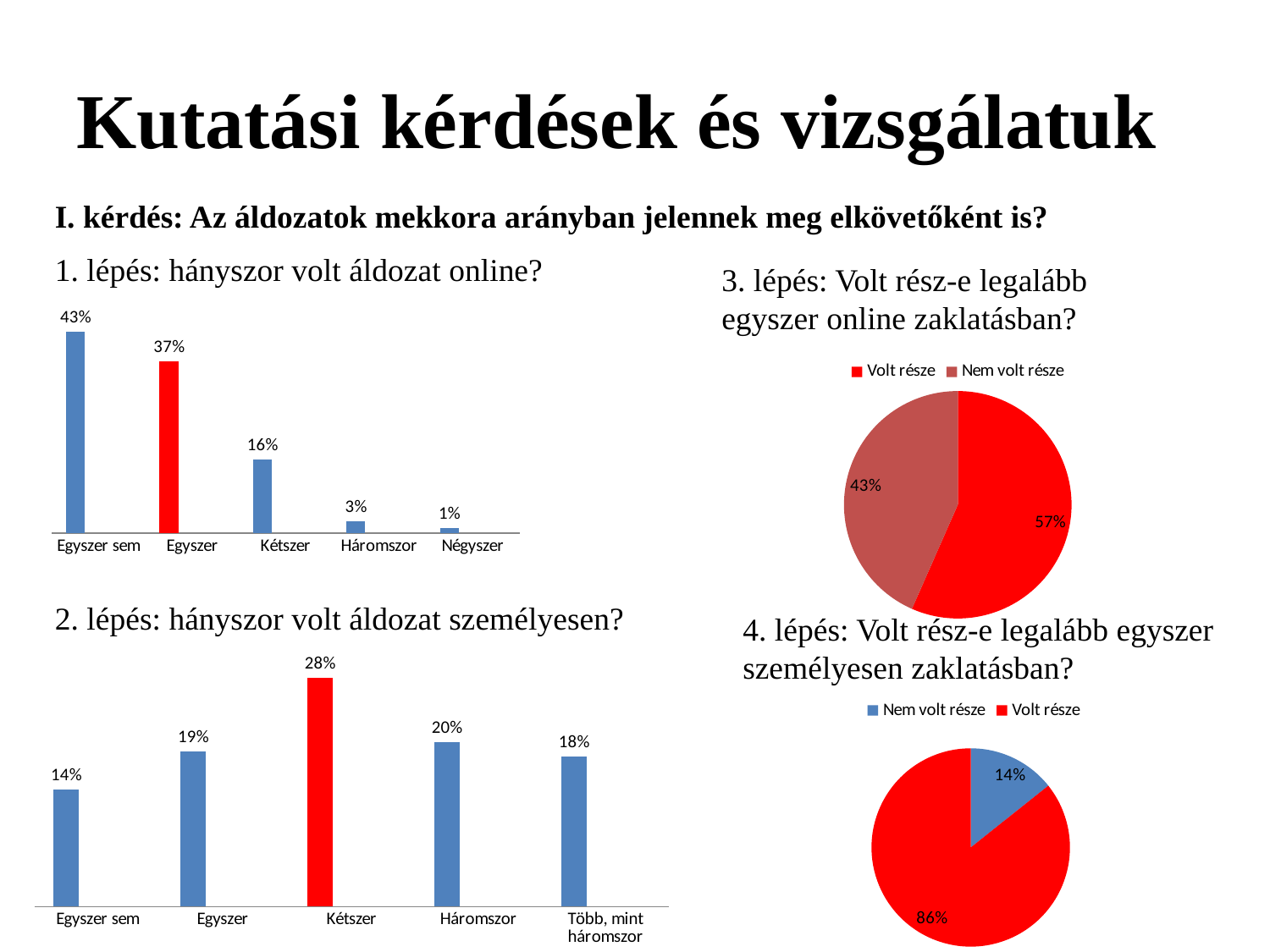
In the top-left bar chart (1. lépés: hányszor volt áldozat online?), which category has the lowest value? Négyszer In the bottom-right pie chart (4. lépés: Volt rész-e legalább egyszer személyesen zaklatásban?), what share is Nem volt része? 14% How many entries does the legend of the top-right pie chart (3. lépés) list? 2 In the bottom-right pie chart (4. lépés: Volt rész-e legalább egyszer személyesen zaklatásban?), which slice is larger: Volt része or Nem volt része? Volt része In the bottom-left bar chart (2. lépés: hányszor volt áldozat személyesen?), what is the value for Több, mint háromszor? 18% In the bottom-left bar chart (2. lépés: hányszor volt áldozat személyesen?), which category has the highest value? Kétszer In the bottom-left bar chart (2. lépés: hányszor volt áldozat személyesen?), which is larger: Egyszer or Háromszor? Háromszor In the top-left bar chart (1. lépés: hányszor volt áldozat online?), what is the value for Egyszer sem? 43% How many categories are shown in the top-left bar chart (1. lépés: hányszor volt áldozat online?)? 5 What type of chart is used for 2. lépés: hányszor volt áldozat személyesen? Bar chart In the top-right pie chart (3. lépés: Volt rész-e legalább egyszer online zaklatásban?), what share is Volt része? 57% In the top-left bar chart (1. lépés: hányszor volt áldozat online?), what is the difference between Egyszer sem and Egyszer? 6%